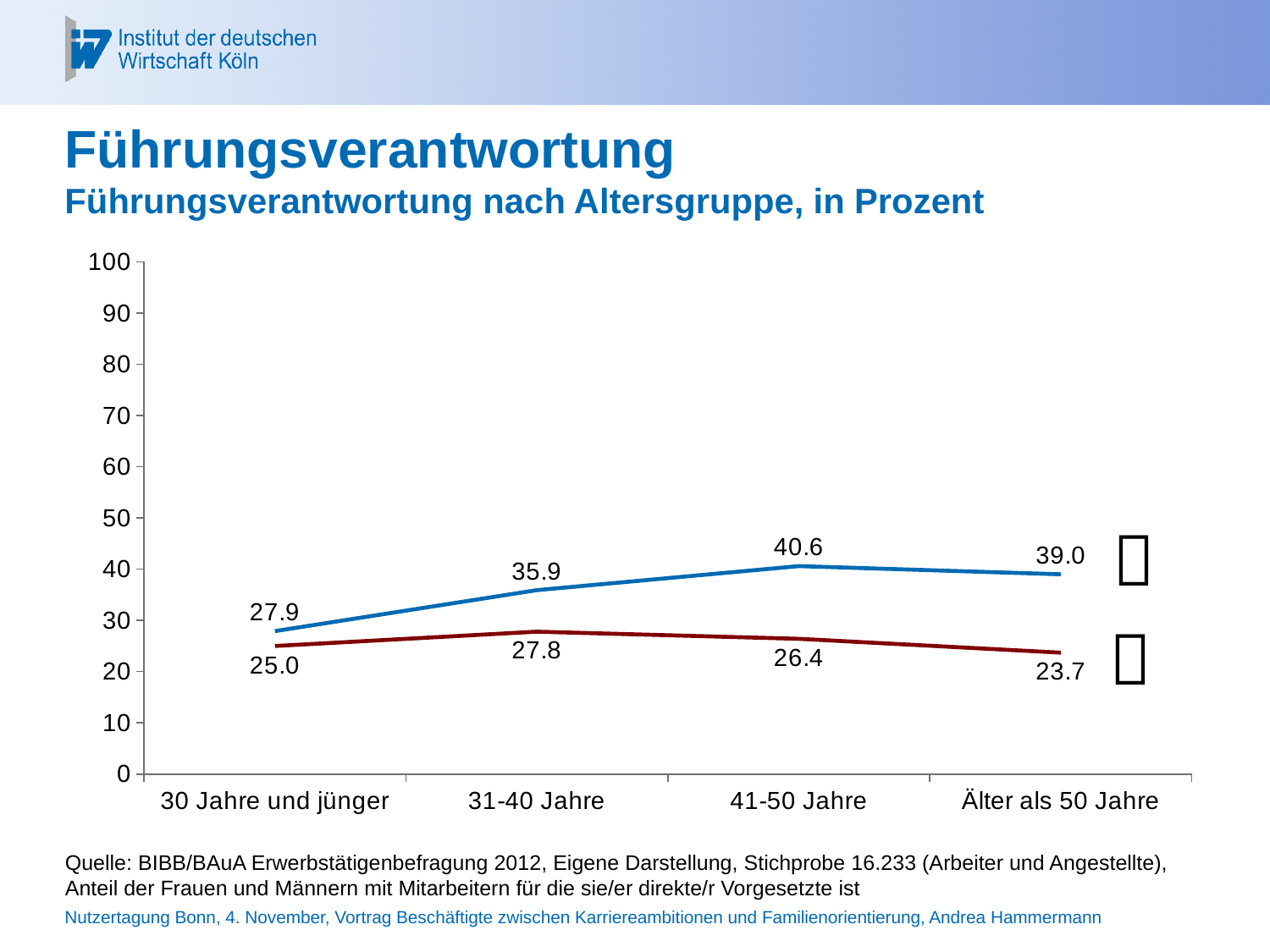
What is the value of the blue line for the age group Älter als 50 Jahre? 39.0 What is the value of the blue line for the age group 41-50 Jahre? 40.6 How many lines are plotted in the chart? 2 For which age group does the blue line reach its highest value? 41-50 Jahre What is the difference between the blue line and the dark red line for the age group 41-50 Jahre? 14.2 Does the dark red line rise or fall from 31-40 Jahre to Älter als 50 Jahre? fall What is the value of the dark red line for the age group 31-40 Jahre? 27.8 For which age group does the dark red line have its lowest value? Älter als 50 Jahre How many age groups are shown on the x axis? 4 Which line has the larger value for the age group 31-40 Jahre, the blue line or the dark red line? the blue line What type of chart is shown on the slide? line chart What is the value of the dark red line for the age group 30 Jahre und jünger? 25.0